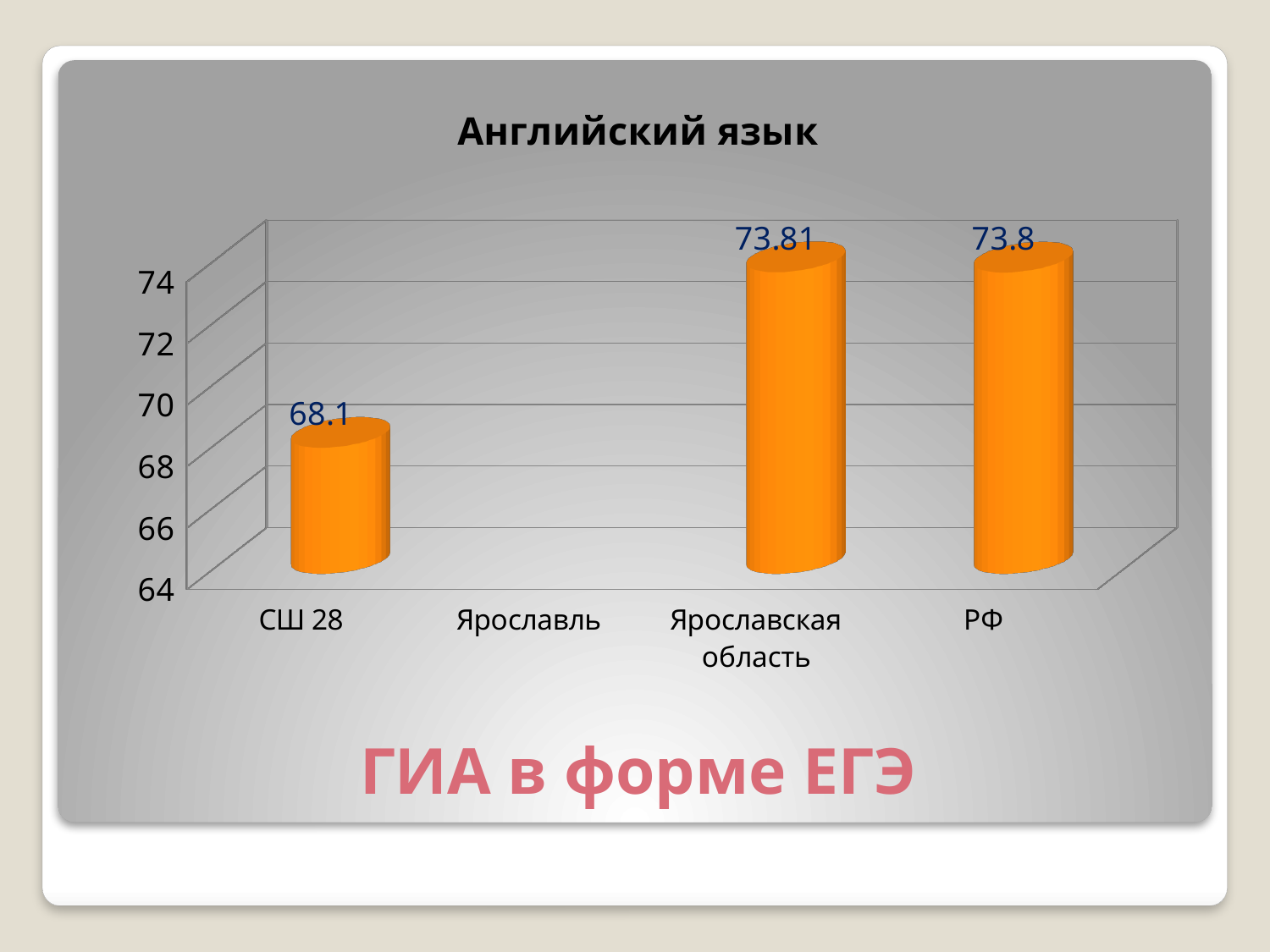
What kind of chart is shown on the slide? bar chart What is the difference between the values for Ярославская область and СШ 28? 5.71 How many categories are shown on the x axis? 4 Is the value for СШ 28 greater or less than 70? less What is the value for Ярославская область? 73.81 What is the value for РФ? 73.8 What is the difference between the values for РФ and СШ 28? 5.7 Is the value for РФ greater or less than 72? greater Which category has the lowest value? СШ 28 Which is larger, the value for СШ 28 or the value for РФ? РФ What is the title of the chart? Английский язык What is the value for СШ 28? 68.1